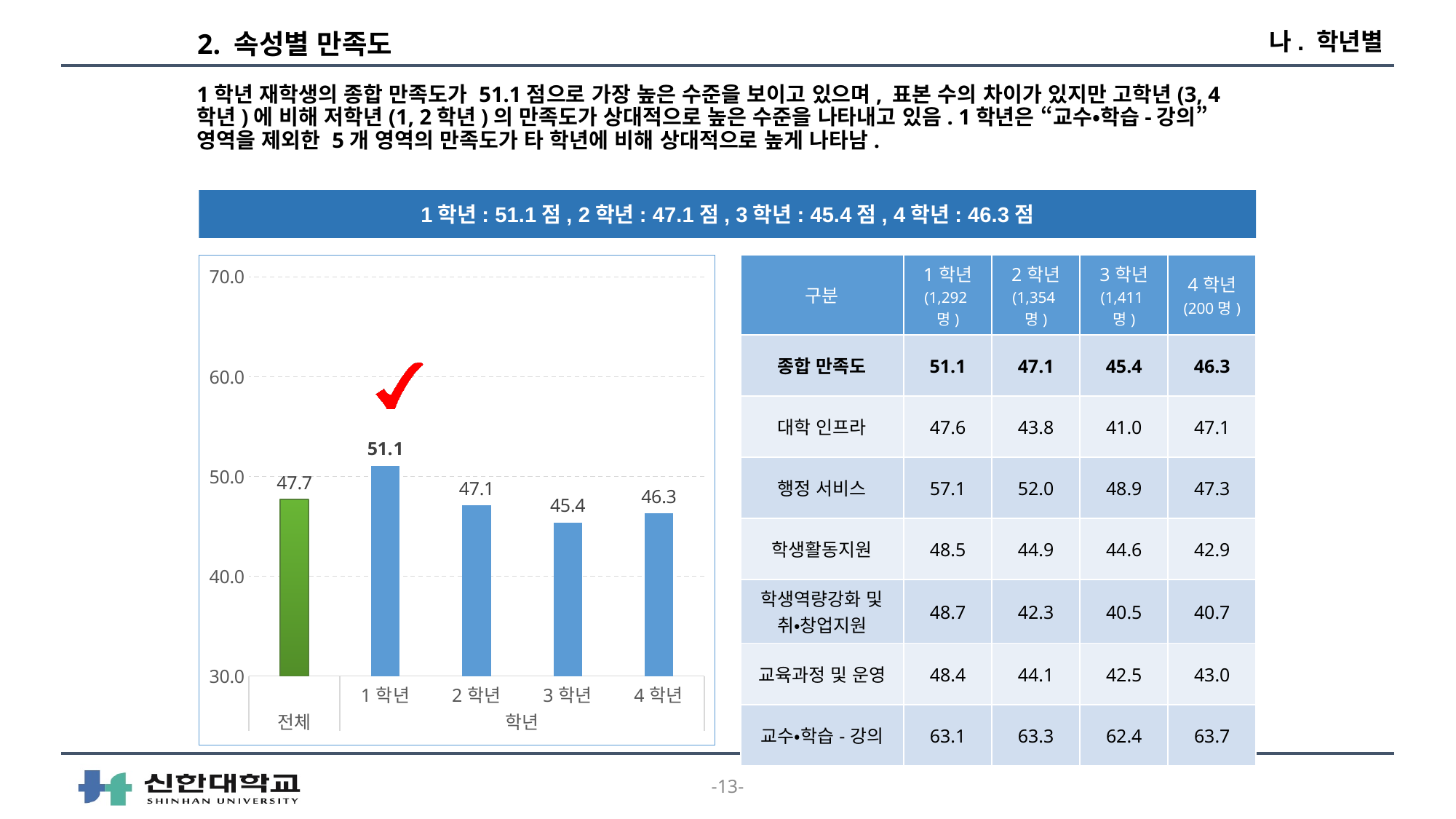
What is the difference between the values for 전체 and 2 학년 in the bar chart? 0.6 What is the difference between the values for 1 학년 and 3 학년 in the bar chart? 5.7 What is the value shown for 3 학년 in the bar chart? 45.4 Which category has the highest value in the bar chart? 1 학년 Which category has the lowest value in the bar chart? 3 학년 What colour is the bar for 전체 in the bar chart? green What is the value shown for 1 학년 in the bar chart? 51.1 How many bars are plotted in the bar chart? 5 What kind of chart is shown on the slide? bar chart Which is larger in the bar chart, the value for 2 학년 or the value for 4 학년? 2 학년 Is the value for 1 학년 in the bar chart greater or less than 50.0? greater What is the value shown for 전체 in the bar chart? 47.7